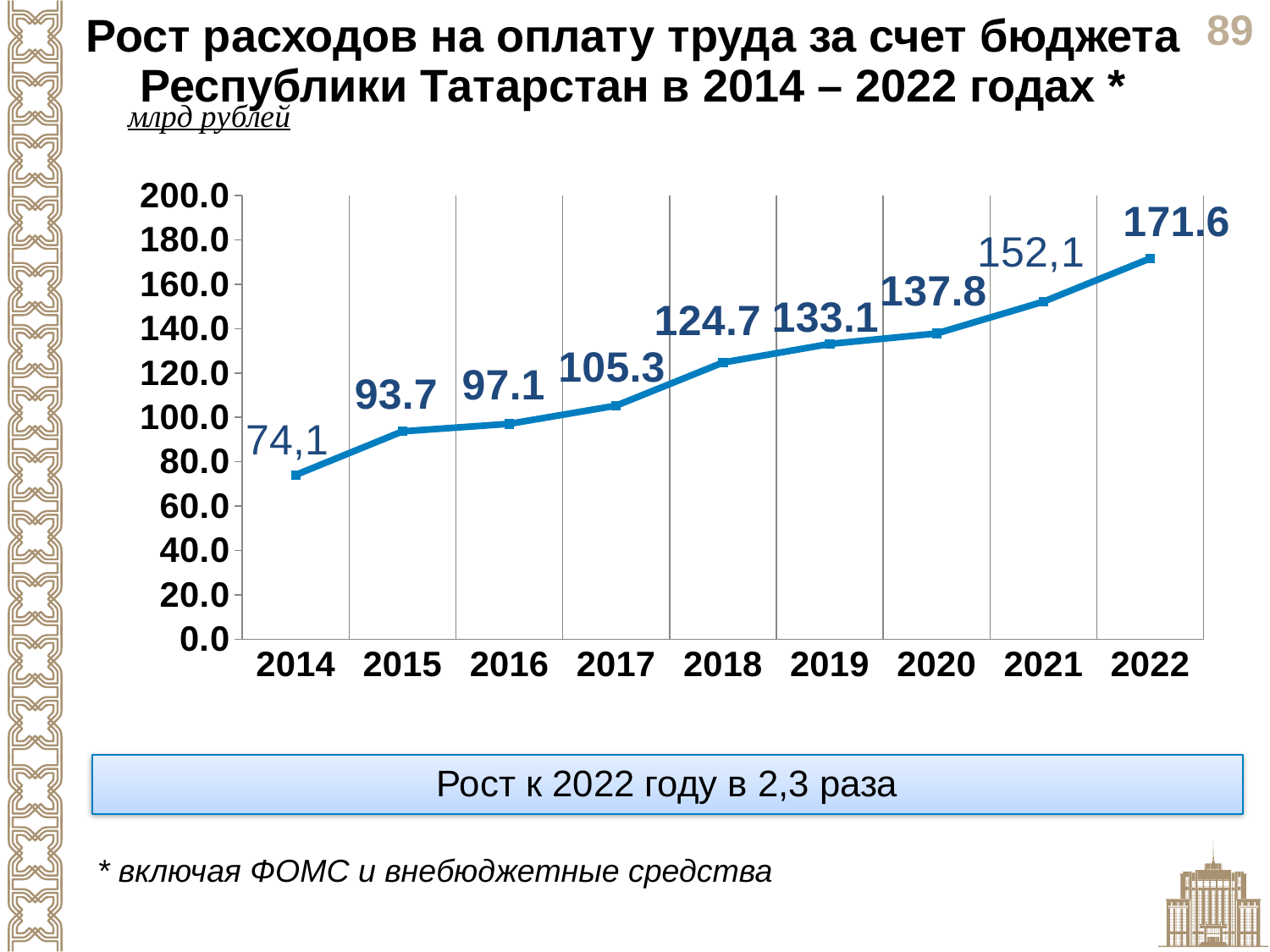
What is the value for 2018? 124.7 Do the values rise or fall from 2014 to 2022? rise What kind of chart is shown on the slide? line chart What is the difference between the values for 2019 and 2018? 8.4 What is the value for 2022? 171.6 Which year has the highest value? 2022 What is the value for 2021? 152,1 How many years are plotted on the x axis? 9 Which is larger, the value for 2016 or the value for 2020? 2020 What is the difference between the values for 2018 and 2017? 19.4 Which year has the lowest value? 2014 What is the value for 2014? 74,1